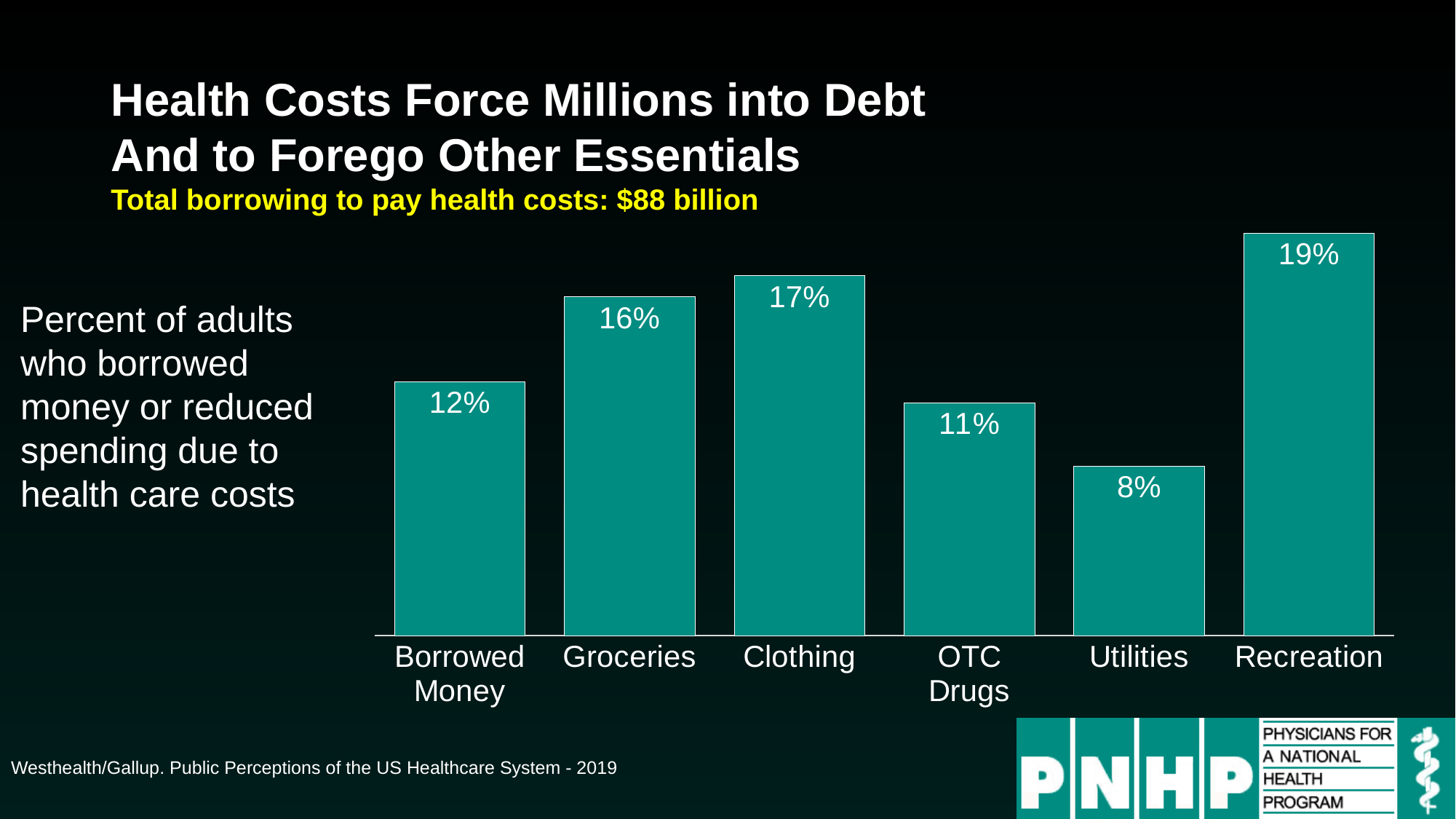
What percent of adults reduced spending on Groceries due to health care costs? 16% Which category has the highest value? Recreation What is the value shown for Utilities? 8% What kind of chart is shown on the slide? Bar chart What is the difference between the values for Recreation and Utilities? 11% Which is larger, the value for Clothing or the value for OTC Drugs? Clothing What percent of adults borrowed money due to health care costs, according to the Borrowed Money bar? 12% What is the value shown for OTC Drugs? 11% What total borrowing to pay health costs is stated on the slide? $88 billion What is the difference between the values for Clothing and Groceries? 1% How many categories are shown in the chart? 6 Which category has the lowest value? Utilities